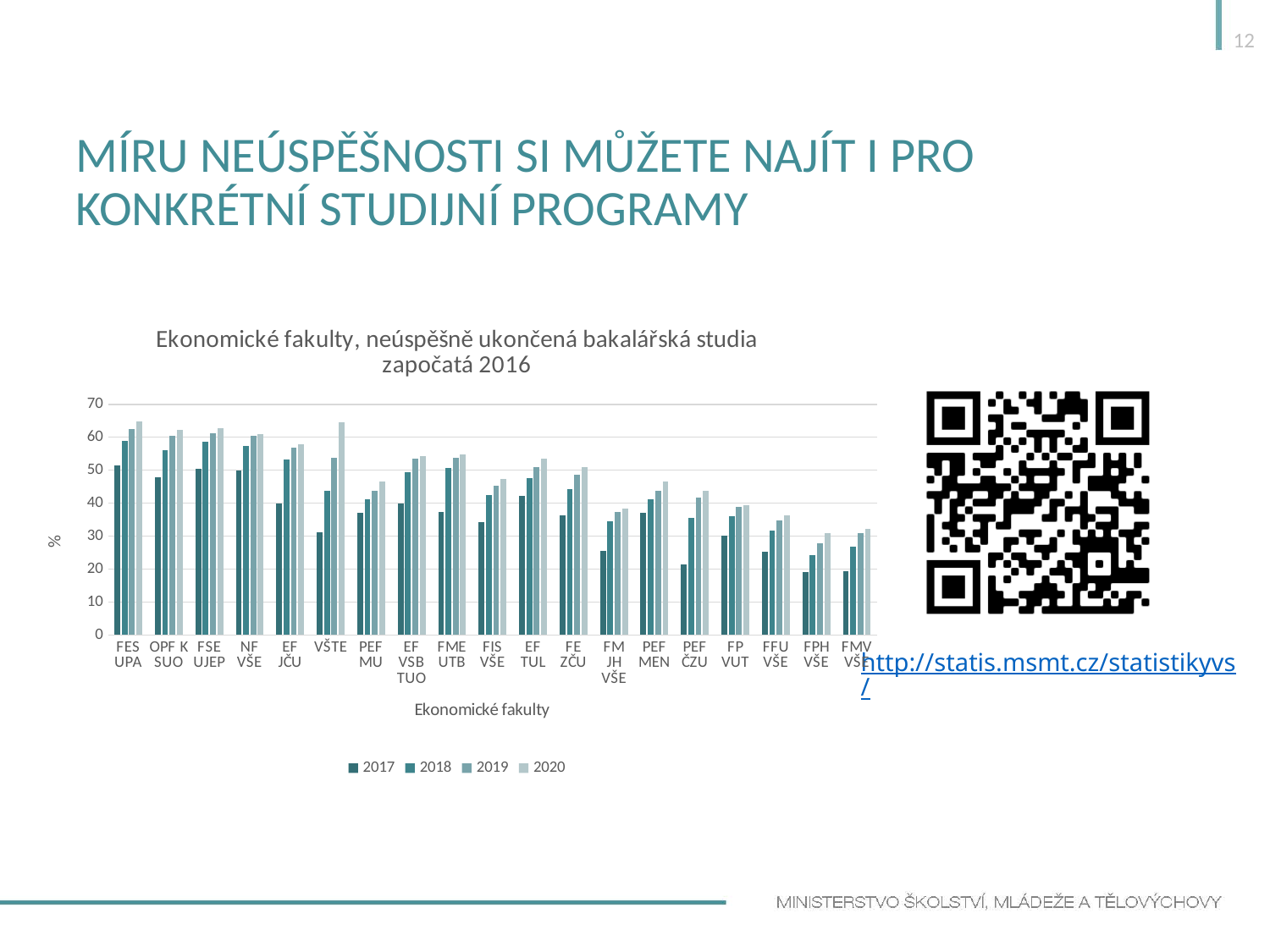
Is the 2020 value for FFU VŠE greater or less than 40? less Which is larger, the 2017 value for FES UPA or the 2017 value for FMV VŠE? FES UPA For FES UPA, do the values rise or fall from 2017 to 2020? rise What is the title of the chart? Ekonomické fakulty, neúspěšně ukončená bakalářská studia započatá 2016 Is the 2020 value for VŠTE greater or less than 60? greater Is the 2020 value for FES UPA greater or less than 60? greater How many faculties (categories) are shown on the x axis? 19 Which is larger, the 2020 value for NF VŠE or the 2020 value for PEF MU? NF VŠE How many series does the legend list? 4 What kind of chart is shown on the slide? bar chart